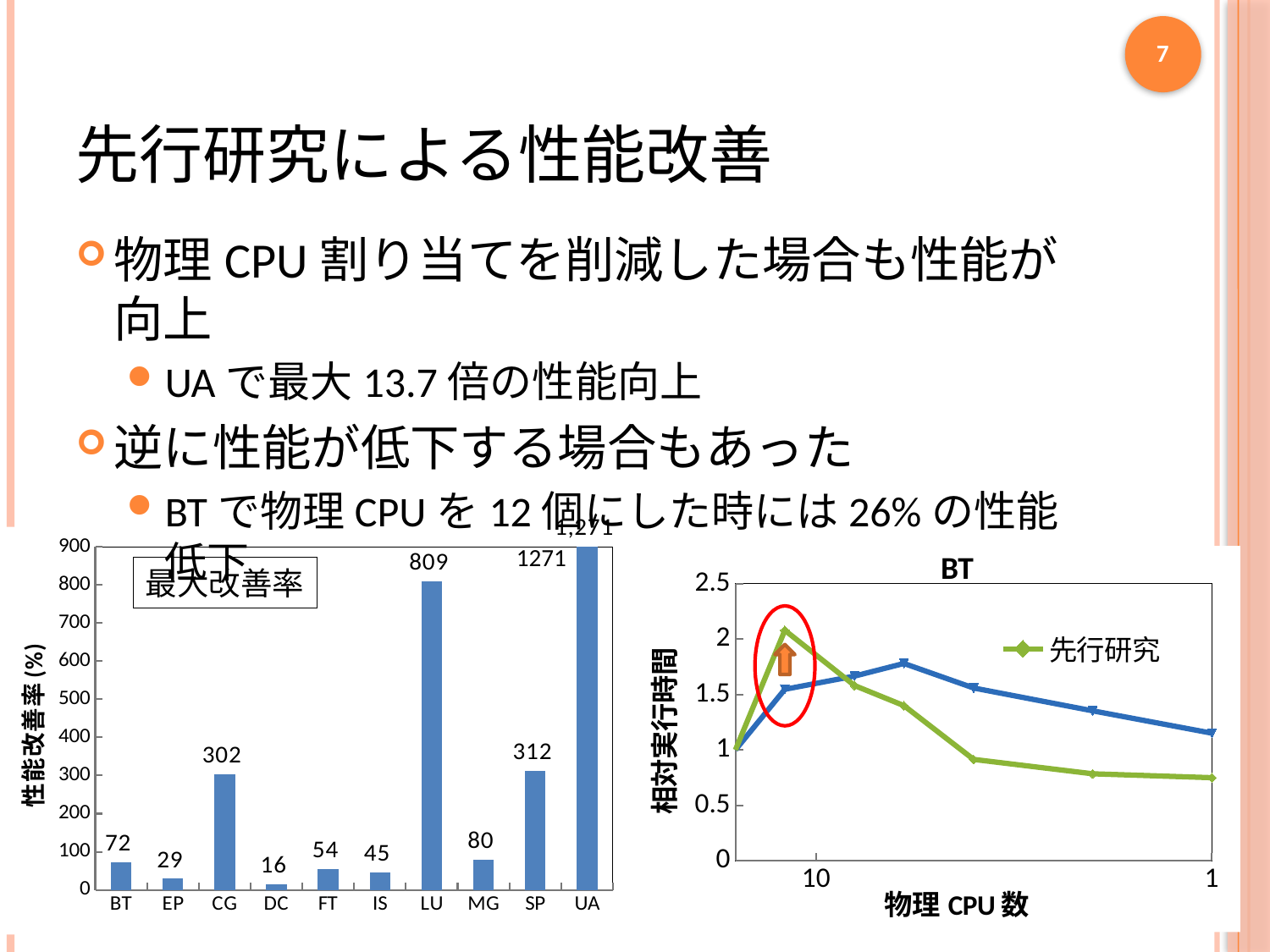
In the chart titled BT, what series name does the legend show? 先行研究 In the chart titled BT, what is the label on the x axis? 物理 CPU 数 In the left bar chart, which category has the lowest value? DC What kind of chart is the chart on the left? bar chart In the left bar chart, what is the difference between the values for SP and CG? 10 In the left bar chart, what is the value for CG? 302 In the left bar chart, what is the value for DC? 16 In the left bar chart, which is larger, the value for BT or the value for MG? MG In the left bar chart, what is the value for LU? 809 What kind of chart is the chart titled BT on the right? line chart How many categories are shown in the left bar chart? 10 In the left bar chart, which category has the highest value? UA